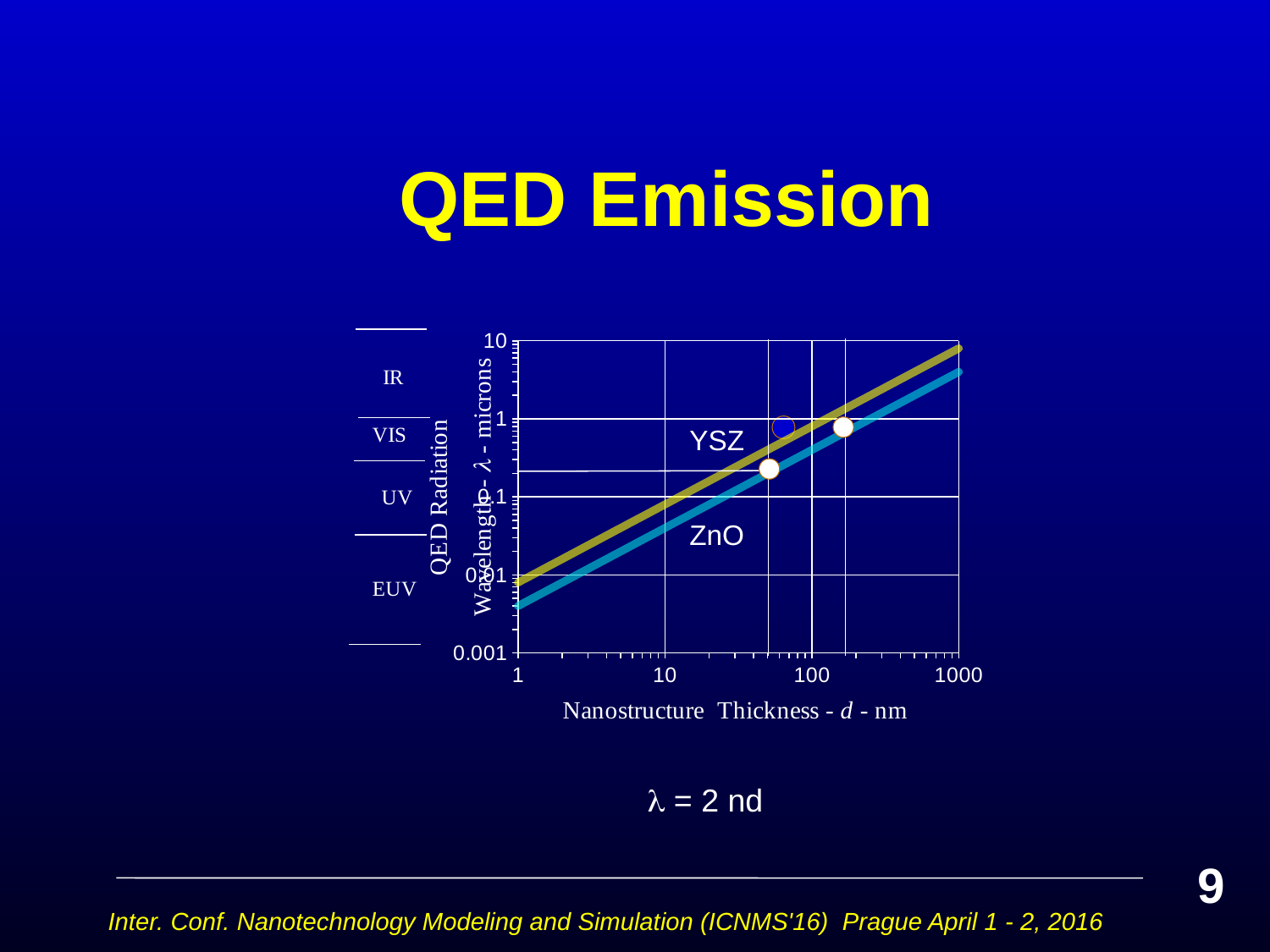
What is the title of the slide containing the chart? QED Emission At a thickness of 100 nm, is the wavelength for ZnO greater or less than 1 micron? less What kind of chart is shown on the slide? line chart Which line lies higher on the chart, YSZ or ZnO? YSZ How many lines (series) are plotted on the chart? 2 At a thickness of 1000 nm, is the wavelength for ZnO greater or less than 1 micron? greater How many labelled tick values are shown on the x axis? 4 What is the label of the x axis? Nanostructure Thickness - d - nm At a thickness of 1 nm, is the wavelength for ZnO greater or less than 0.01 microns? less What are the names of the two series plotted on the chart? YSZ and ZnO Do the wavelength values rise or fall as nanostructure thickness increases along the x axis? rise